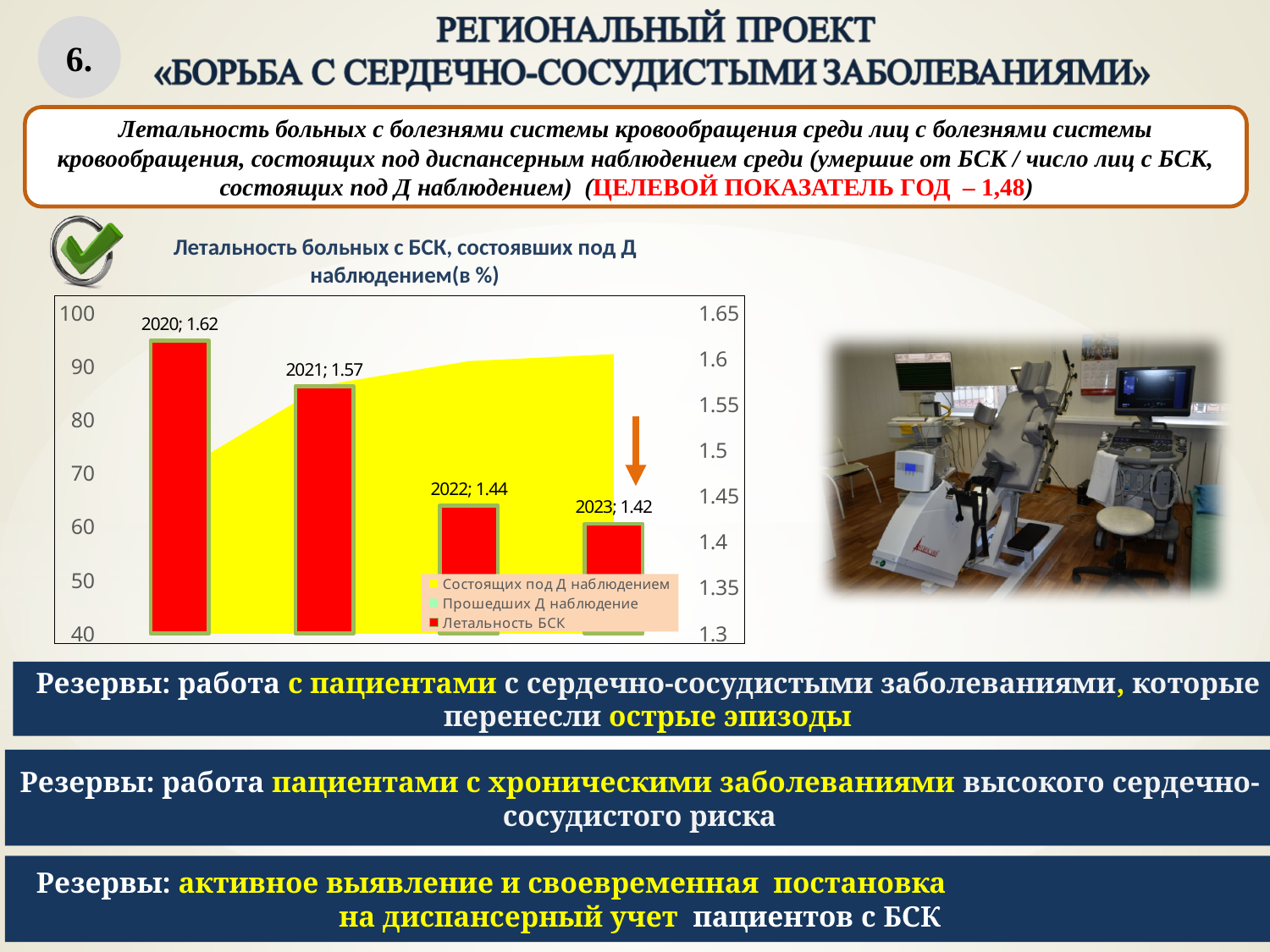
What is the value of Летальность БСК for 2020? 1.62 What is the value of Летальность БСК for 2022? 1.44 What is the difference between the Летальность БСК values for 2020 and 2023? 0.2 What is the value of Летальность БСК for 2023? 1.42 How many series does the chart legend list? 3 Which year has the lowest value of Летальность БСК? 2023 What is the value of Летальность БСК for 2021? 1.57 Which year has the highest value of Летальность БСК? 2020 How many years are shown on the x axis of the chart? 4 Which year has a larger Летальность БСК value, 2021 or 2022? 2021 Does the Летальность БСК value rise or fall from 2020 to 2023? Falls What is the difference between the Летальность БСК values for 2021 and 2022? 0.13